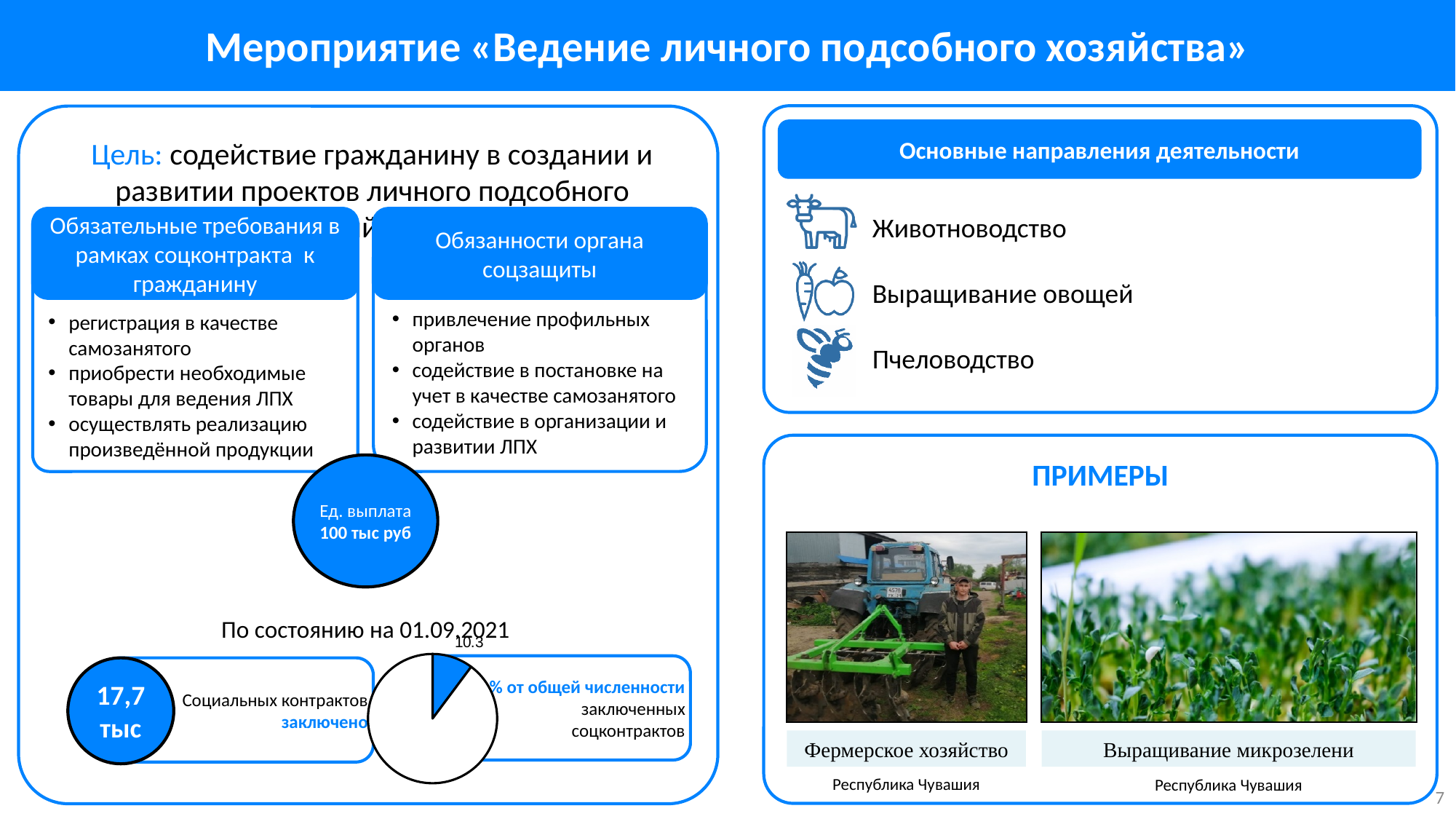
Which slice of the pie chart is larger, the blue one or the white one? white What kind of chart is shown at the bottom of the left panel, next to the text "По состоянию на 01.09.2021"? pie chart Is the blue slice of the pie chart less than or greater than half of the pie? less Which slice of the pie chart is the smallest? the blue slice (10.3) How many slices does the pie chart have? 2 What value is printed as the data label on the blue slice of the pie chart? 10.3 What colour is the slice of the pie chart labelled 10.3? blue